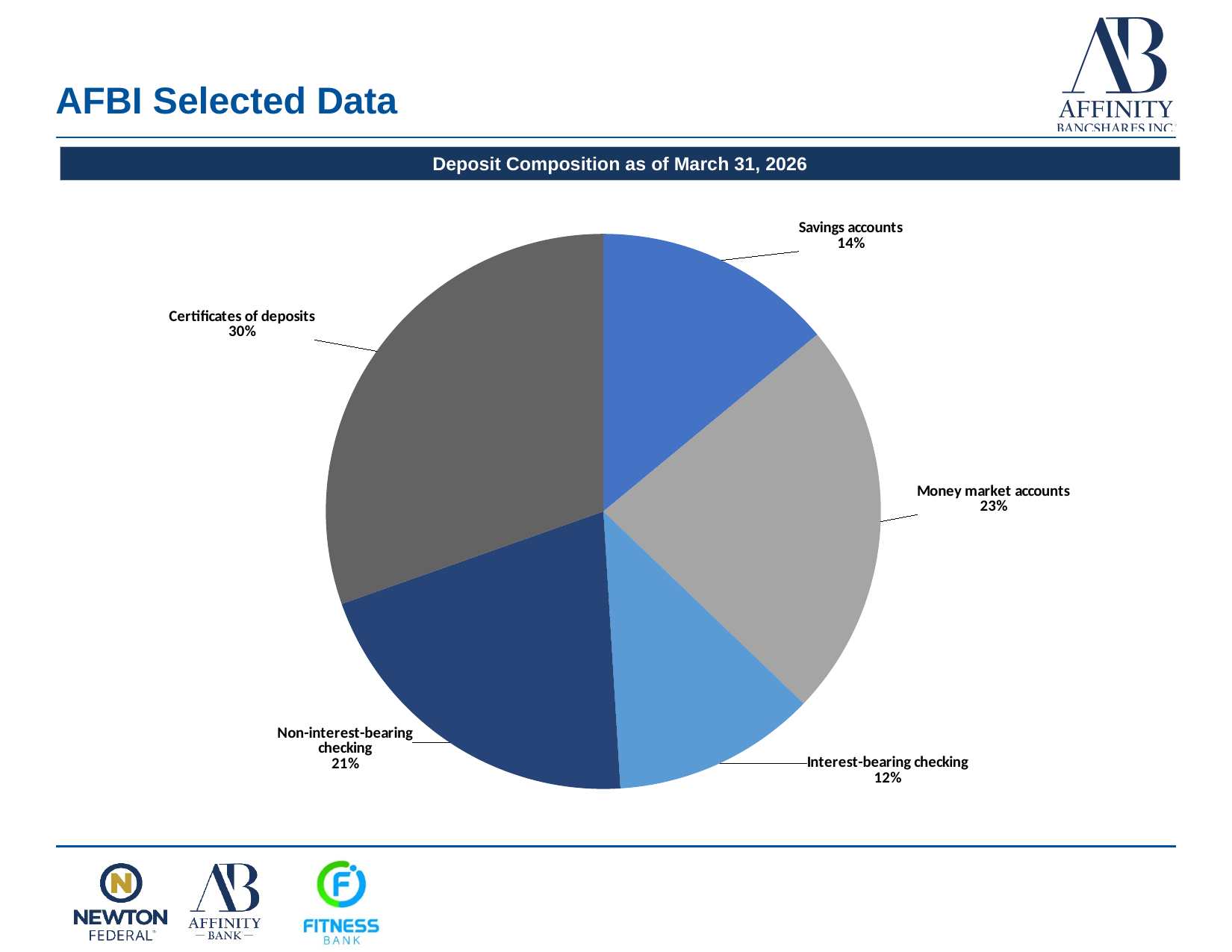
What percentage of deposits is in Savings accounts? 14% What is the difference in percentage points between Certificates of deposits and Non-interest-bearing checking? 9 Which deposit category has the largest share? Certificates of deposits What is the combined share of Non-interest-bearing checking and Interest-bearing checking? 33% What kind of chart is shown on the slide? Pie chart How many deposit categories are shown in the pie chart? 5 What share of deposits do Certificates of deposits represent? 30% Which is larger, Money market accounts or Savings accounts? Money market accounts What percentage of deposits is in Interest-bearing checking? 12% What percentage of deposits is in Money market accounts? 23% Which deposit category has the smallest share? Interest-bearing checking What is the title of the chart? Deposit Composition as of March 31, 2026